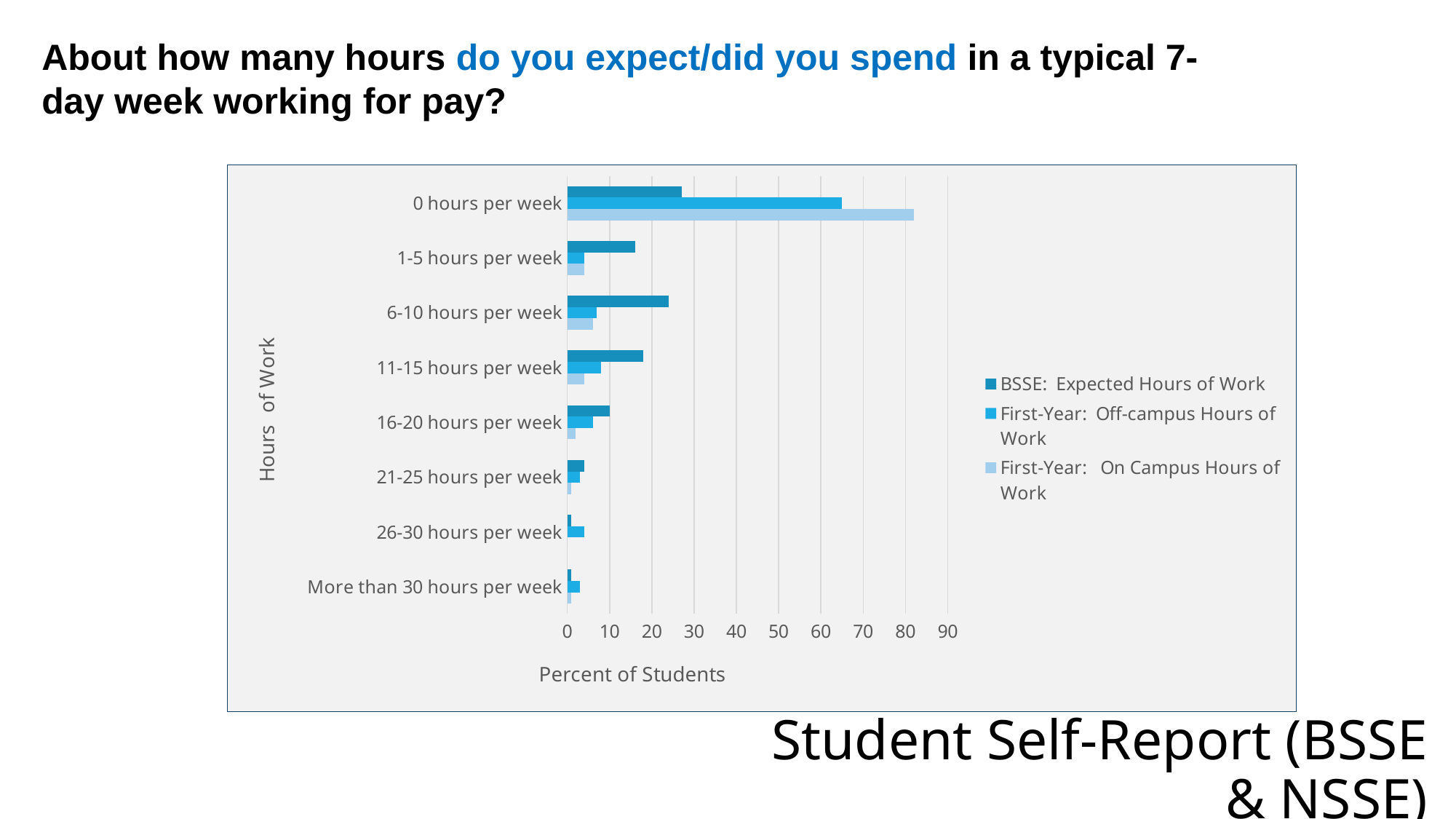
Which category has the highest value for First-Year: On Campus Hours of Work? 0 hours per week What kind of chart is shown on the slide? bar chart How many series does the legend list? 3 Is the BSSE: Expected Hours of Work value for 6-10 hours per week greater or less than 20? greater Is the BSSE: Expected Hours of Work value for 1-5 hours per week greater or less than 20? less How many hours-of-work categories are plotted on the chart? 8 For 1-5 hours per week, which is larger: BSSE: Expected Hours of Work or First-Year: Off-campus Hours of Work? BSSE: Expected Hours of Work Which category has the highest value for First-Year: Off-campus Hours of Work? 0 hours per week Is the First-Year: On Campus Hours of Work value for 0 hours per week greater or less than 70? greater What is the title of the horizontal axis of the chart? Percent of Students For 0 hours per week, which is larger: First-Year: On Campus Hours of Work or First-Year: Off-campus Hours of Work? First-Year: On Campus Hours of Work